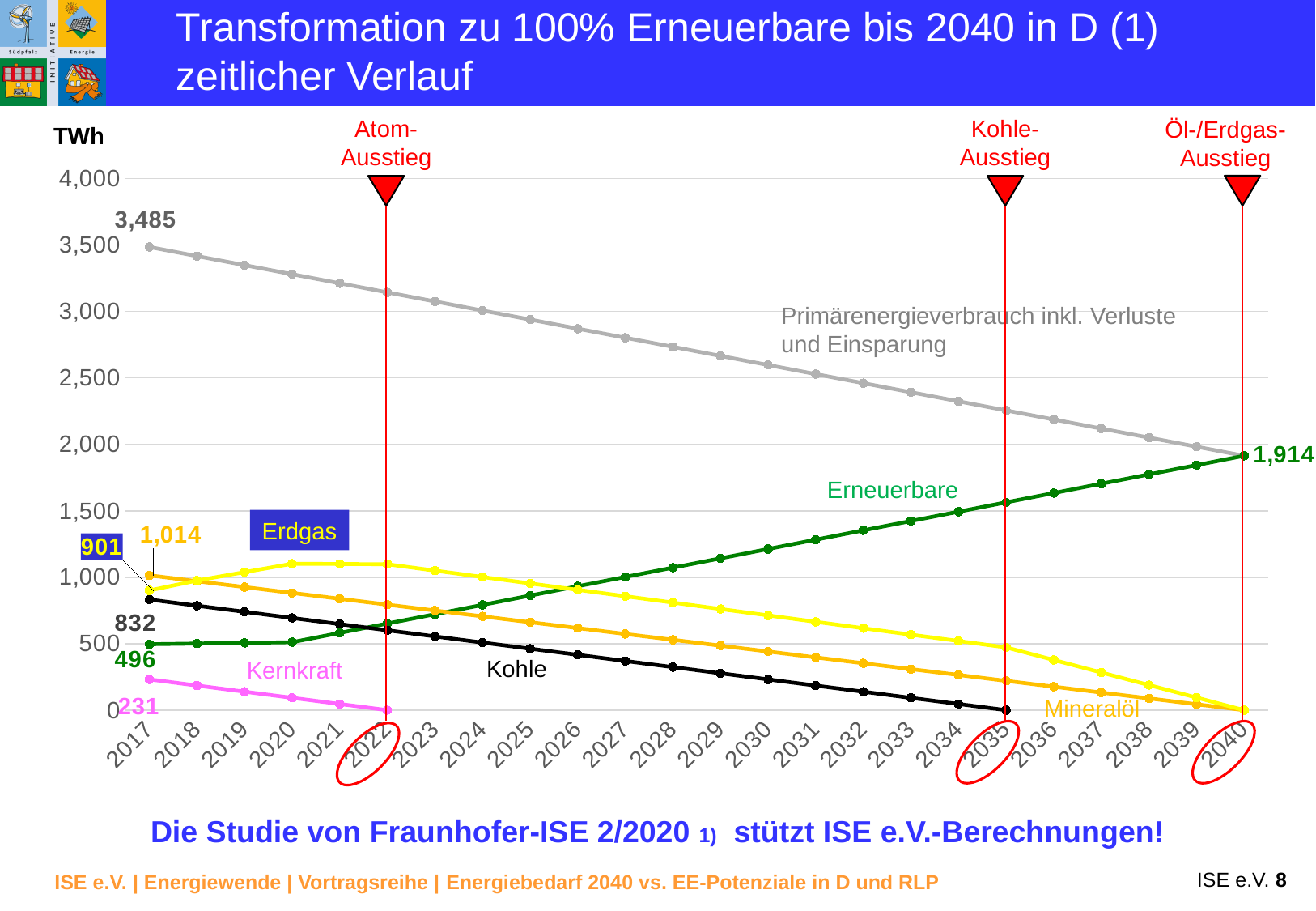
Is the value for Kohle in 2030 greater or less than 500? less How many years are shown on the x axis? 24 Does the Primärenergieverbrauch line rise or fall from 2017 to 2040? fall In which year is the Atom-Ausstieg marked on the chart? 2022 What is the value for Kohle in 2017? 832 What value does the Erneuerbare line reach in 2040? 1,914 What is the value for Kernkraft in 2017? 231 In 2017, which is larger: Mineralöl (1,014) or Erdgas (901)? Mineralöl By how much does Primärenergieverbrauch decrease from 2017 (3,485) to 2040 (1,914)? 1,571 What kind of chart is shown on the slide? line chart By how much does Erneuerbare increase from 2017 to 2040? 1,418 What is the value of Primärenergieverbrauch inkl. Verluste und Einsparung in 2017? 3,485